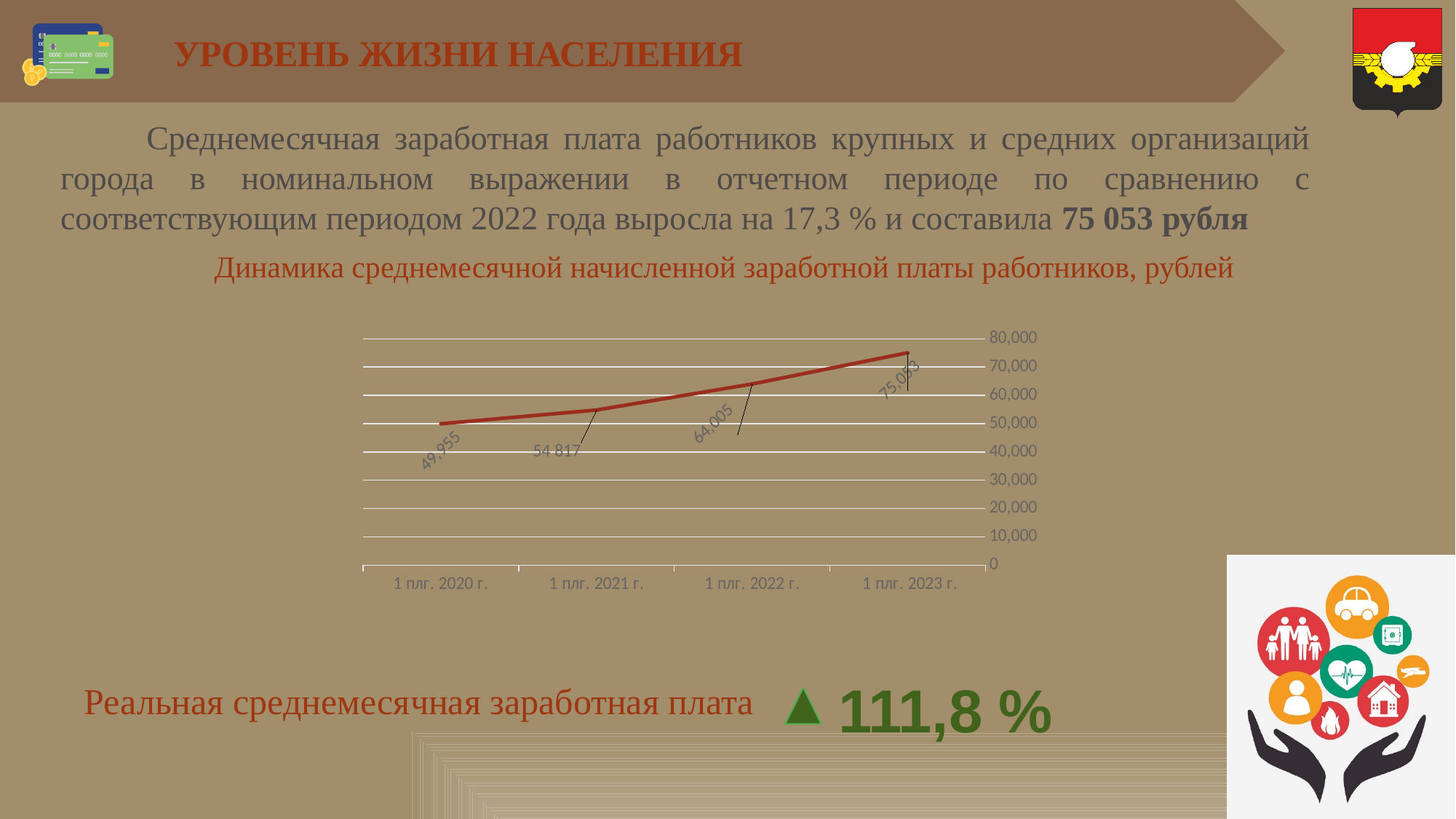
Which period has the highest value? 1 плг. 2023 г. Do the values rise or fall from 1 плг. 2020 г. to 1 плг. 2023 г.? rise What kind of chart is shown on the slide? line chart Which period has the lowest value? 1 плг. 2020 г. What is the value for 1 плг. 2023 г.? 75,053 What is the difference between the values for 1 плг. 2022 г. and 1 плг. 2020 г.? 14,050 What is the difference between the values for 1 плг. 2023 г. and 1 плг. 2022 г.? 11,048 Is the value for 1 плг. 2021 г. greater or less than 60,000? less How many periods are plotted on the chart? 4 What is the value for 1 плг. 2020 г.? 49,955 What is the value for 1 плг. 2022 г.? 64,005 Which is larger, the value for 1 плг. 2021 г. or the value for 1 плг. 2022 г.? 1 плг. 2022 г.